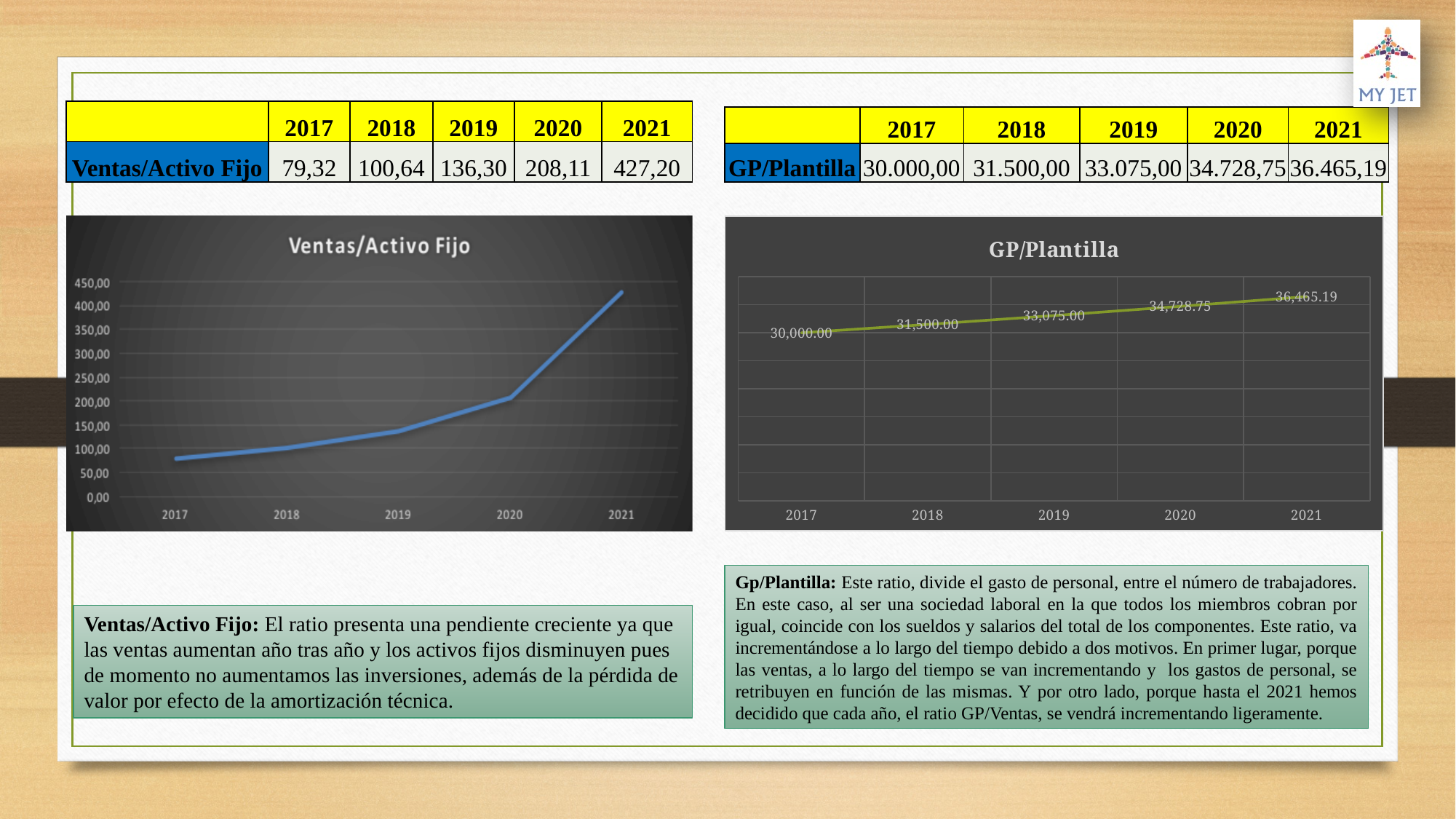
In the GP/Plantilla chart, which year has the highest value? 2021 In the Ventas/Activo Fijo chart, do the values rise or fall from 2017 to 2021? rise In the GP/Plantilla chart, what is the difference between the 2018 and 2017 values? 1,500.00 In the GP/Plantilla chart, what is the value for 2021? 36,465.19 How many years are plotted in the GP/Plantilla chart? 5 In the GP/Plantilla chart, which year has the lowest value? 2017 In the Ventas/Activo Fijo chart, which year has the highest value? 2021 What type of chart is the Ventas/Activo Fijo chart? line chart In the GP/Plantilla chart, what is the value for 2019? 33,075.00 In the Ventas/Activo Fijo chart, is the value for 2021 greater or less than 400,00? greater What is the title of the chart on the right side of the slide? GP/Plantilla In the Ventas/Activo Fijo chart, is the value for 2017 greater or less than 100,00? less